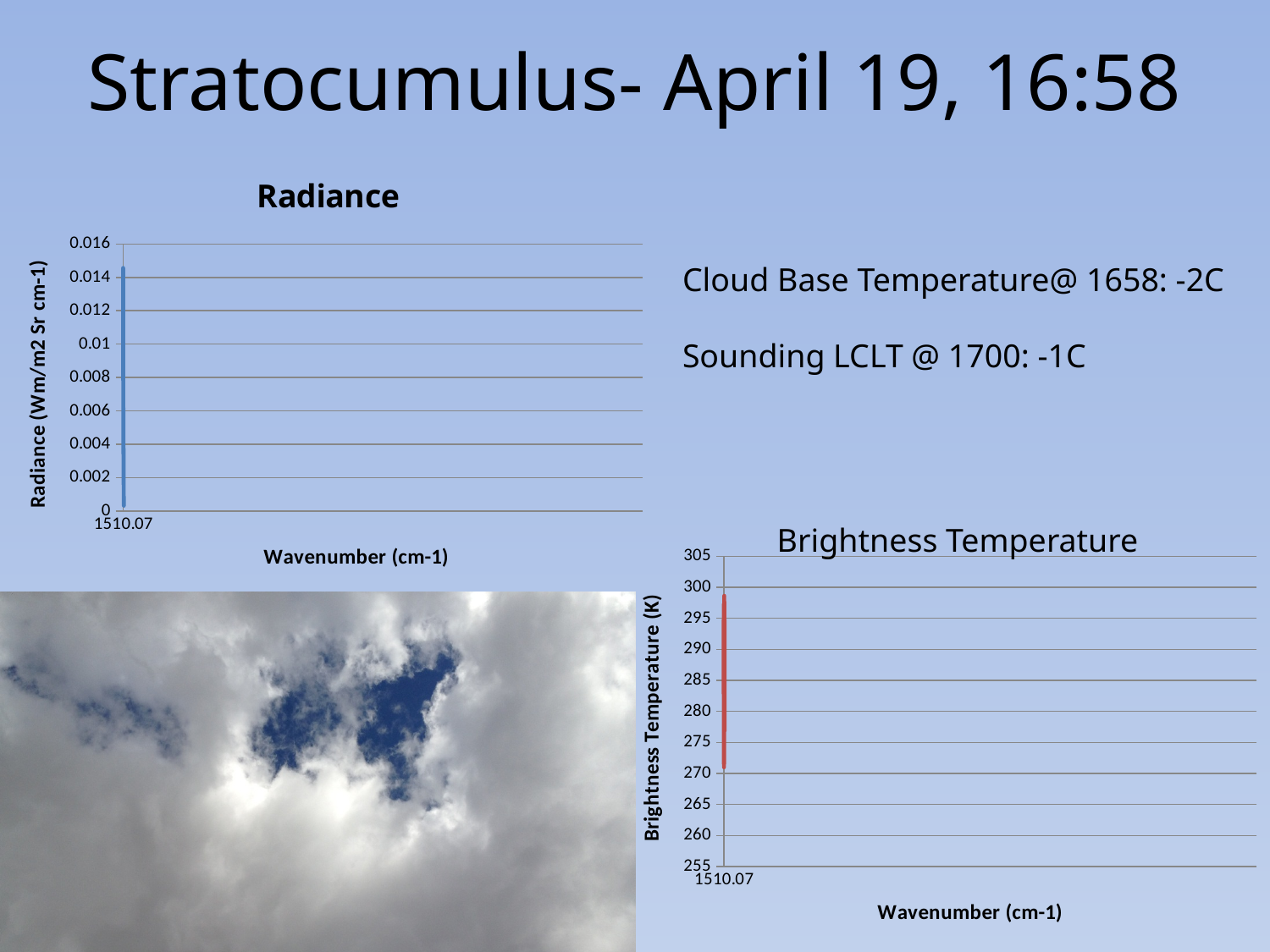
In the Brightness Temperature chart, what is the only x-axis tick label shown? 1510.07 In the Radiance chart, what is the label of the x axis? Wavenumber (cm-1) In the Brightness Temperature chart, what is the label of the y axis? Brightness Temperature (K) In the Radiance chart, what is the highest value shown on the y axis? 0.016 What is the title of the chart in the upper left of the slide? Radiance In the Brightness Temperature chart, what is the lowest value shown on the y axis? 255 In the Brightness Temperature chart, is the highest plotted brightness temperature greater or less than 290? greater In the Radiance chart, what is the only x-axis tick label shown? 1510.07 In the Brightness Temperature chart, is the lowest plotted brightness temperature greater or less than 280? less In the Radiance chart, is the highest plotted radiance value greater or less than 0.012? greater